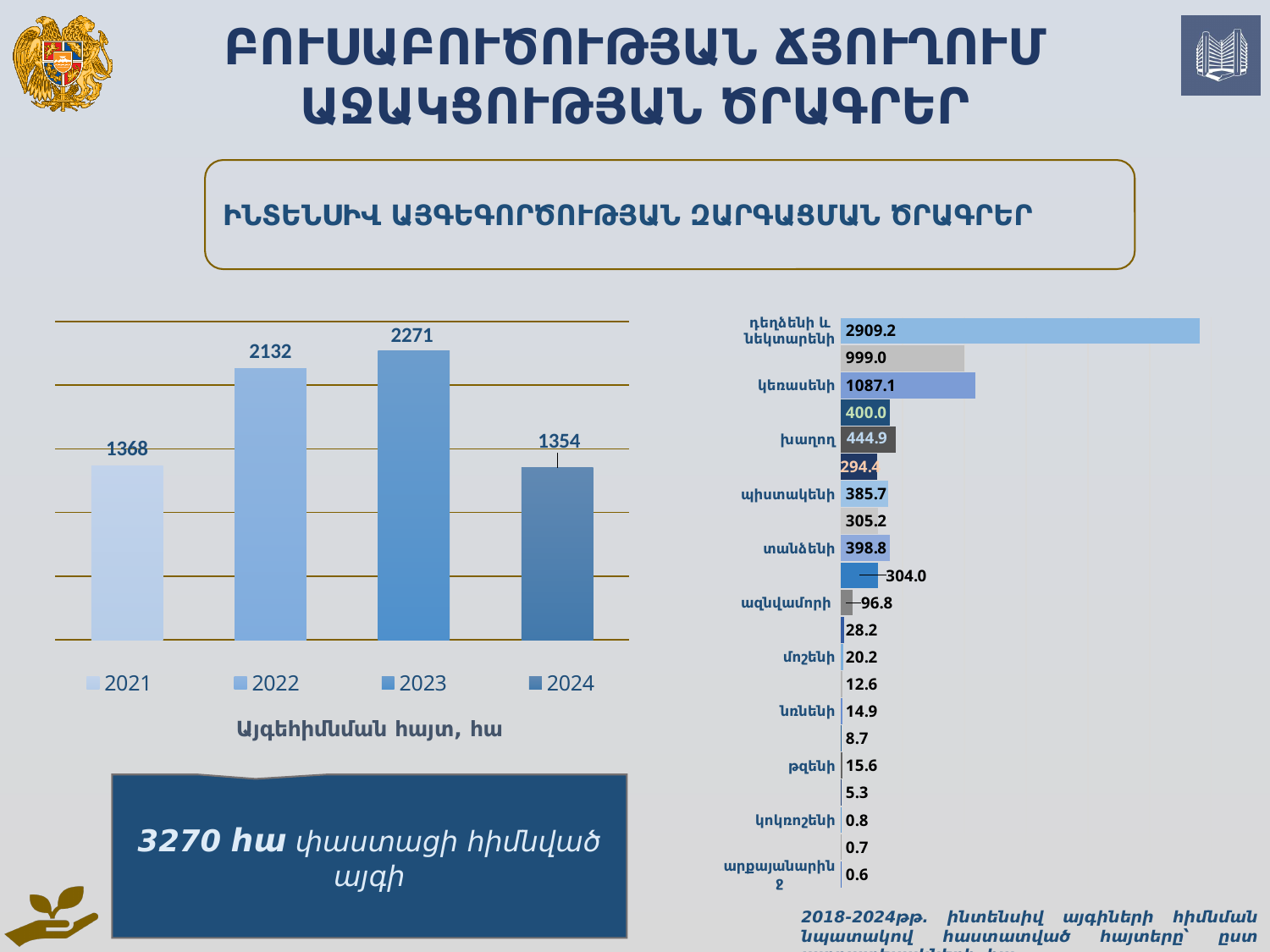
On the left chart (Այգեհիմնման հայտ, հա), what is the value for 2024? 1354 On the left chart (Այգեհիմնման հայտ, հա), what is the value for 2022? 2132 On the left chart (Այգեհիմնման հայտ, հա), which year has the lowest value? 2024 On the left chart (Այգեհիմնման հայտ, հա), what is the difference between the values for 2022 and 2021? 764 On the left chart (Այգեհիմնման հայտ, հա), what is the difference between the values for 2023 and 2022? 139 What kind of chart is the chart on the right side of the slide? Bar chart On the left chart (Այգեհիմնման հայտ, հա), how many years are shown? 4 On the right chart, what is the difference between the value for դեղձենի և նեկտարենի (2909.2) and the value for կեռասենի (1087.1)? 1822.1 On the right chart, what is the highest value shown? 2909.2 On the left chart (Այգեհիմնման հայտ, հա), which year has the highest value? 2023 On the left chart (Այգեհիմնման հայտ, հա), how many entries does the legend list? 4 On the left chart (Այգեհիմնման հայտ, հա), which is larger, the value for 2021 or the value for 2024? 2021